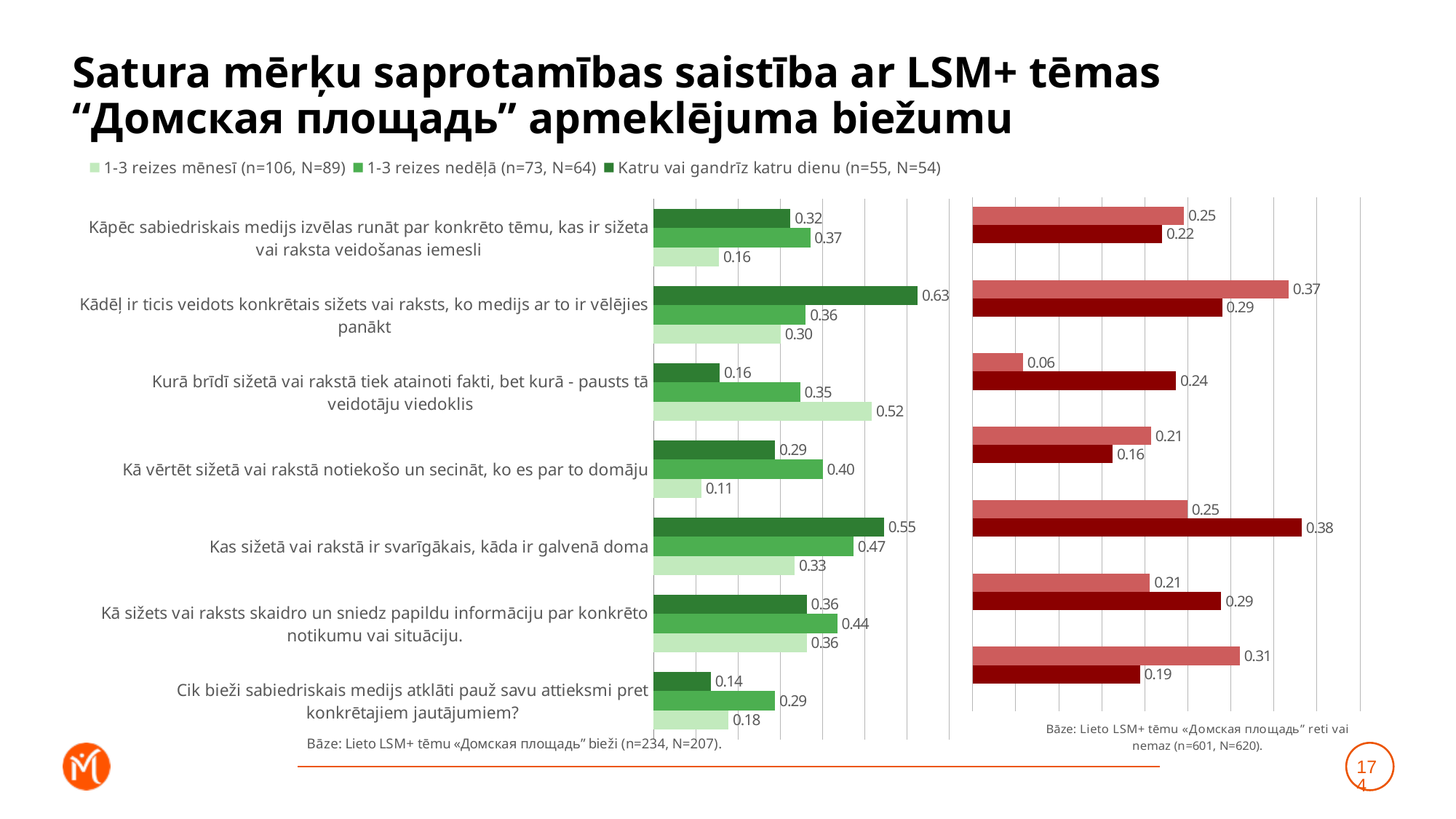
In the green chart on the left, which category has the lowest value for the '1-3 reizes mēnesī' series? Kā vērtēt sižetā vai rakstā notiekošo un secināt, ko es par to domāju In the green chart on the left, what is the difference between the 'Katru vai gandrīz katru dienu' and '1-3 reizes mēnesī' values for 'Kādēļ ir ticis veidots konkrētais sižets vai raksts, ko medijs ar to ir vēlējies panākt'? 0.33 In the green chart on the left, what is the value for '1-3 reizes nedēļā' for 'Cik bieži sabiedriskais medijs atklāti pauž savu attieksmi pret konkrētajiem jautājumiem?'? 0.29 In the green chart on the left, which category has the highest value for the 'Katru vai gandrīz katru dienu' series? Kādēļ ir ticis veidots konkrētais sižets vai raksts, ko medijs ar to ir vēlējies panākt How many series does the legend of the green chart on the left list? 3 In the red chart on the right, what is the value of the darker red bar for 'Kas sižetā vai rakstā ir svarīgākais, kāda ir galvenā doma'? 0.38 How many categories (statements) are shown on the green chart on the left? 7 In the green chart on the left, what is the value for '1-3 reizes mēnesī' for 'Kurā brīdī sižetā vai rakstā tiek atainoti fakti, bet kurā - pausts tā veidotāju viedoklis'? 0.52 According to the legend of the green chart, what sample sizes are given for the 'Katru vai gandrīz katru dienu' series? n=55, N=54 In the green chart on the left, what is the value for 'Katru vai gandrīz katru dienu' for 'Kādēļ ir ticis veidots konkrētais sižets vai raksts, ko medijs ar to ir vēlējies panākt'? 0.63 What kind of chart is the green chart on the left? bar chart In the green chart on the left, for 'Kas sižetā vai rakstā ir svarīgākais, kāda ir galvenā doma', which series has the larger value: 'Katru vai gandrīz katru dienu' or '1-3 reizes nedēļā'? Katru vai gandrīz katru dienu